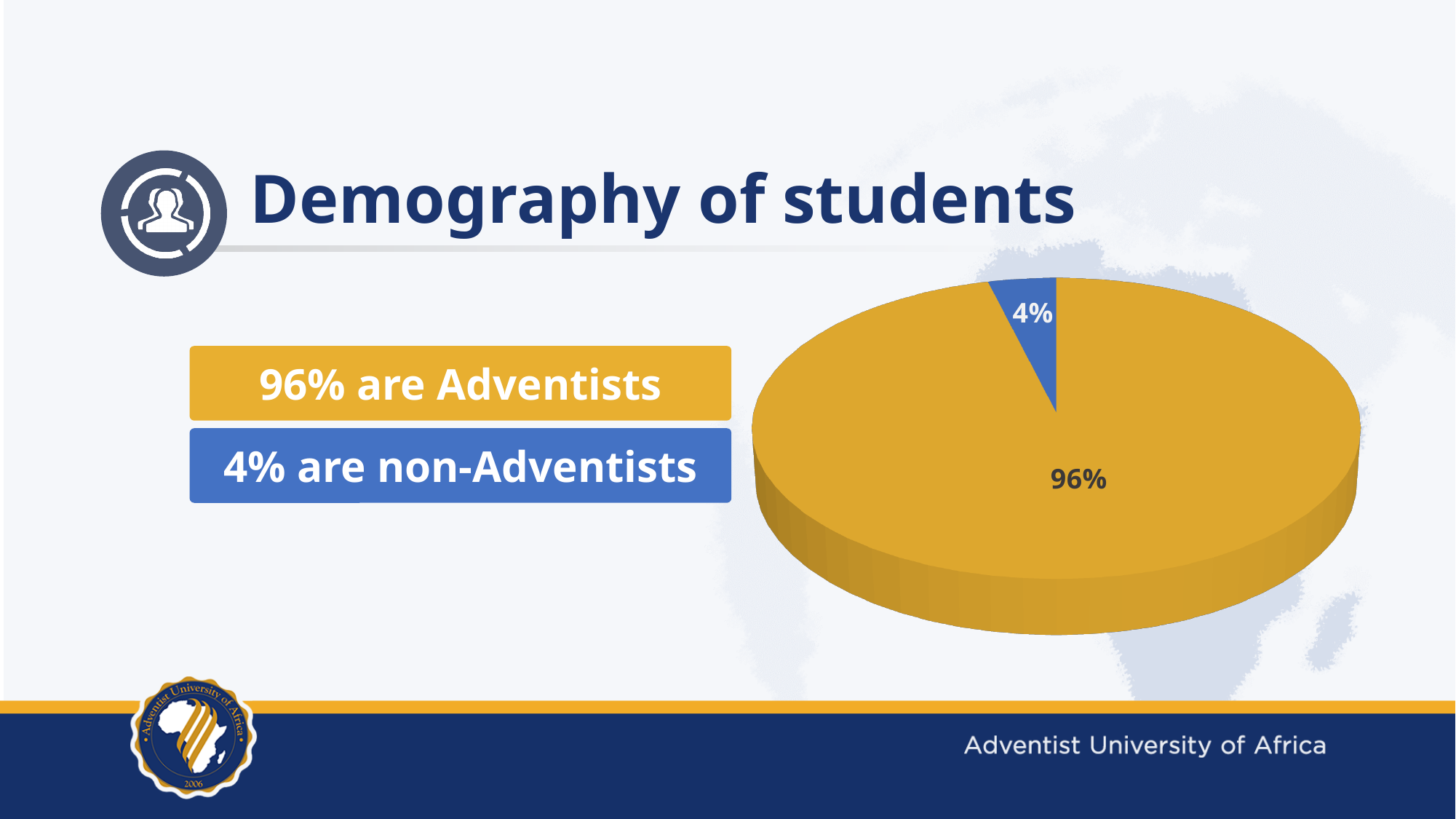
What percentage of students are non-Adventists according to the pie chart? 4% What is the difference in percentage points between the Adventist and non-Adventist slices? 92 What colour is the slice representing Adventists? gold/yellow Which group has the smallest slice of the pie chart? non-Adventists What is the total of the two slices shown in the pie chart? 100% What kind of chart is shown on the slide? pie chart Which slice is larger, Adventists or non-Adventists? Adventists What share of the pie does the non-Adventist slice represent? 4% What colour is the slice representing non-Adventists? blue Which group has the largest slice of the pie chart? Adventists How many slices does the pie chart have? 2 What percentage of students are Adventists according to the pie chart? 96%